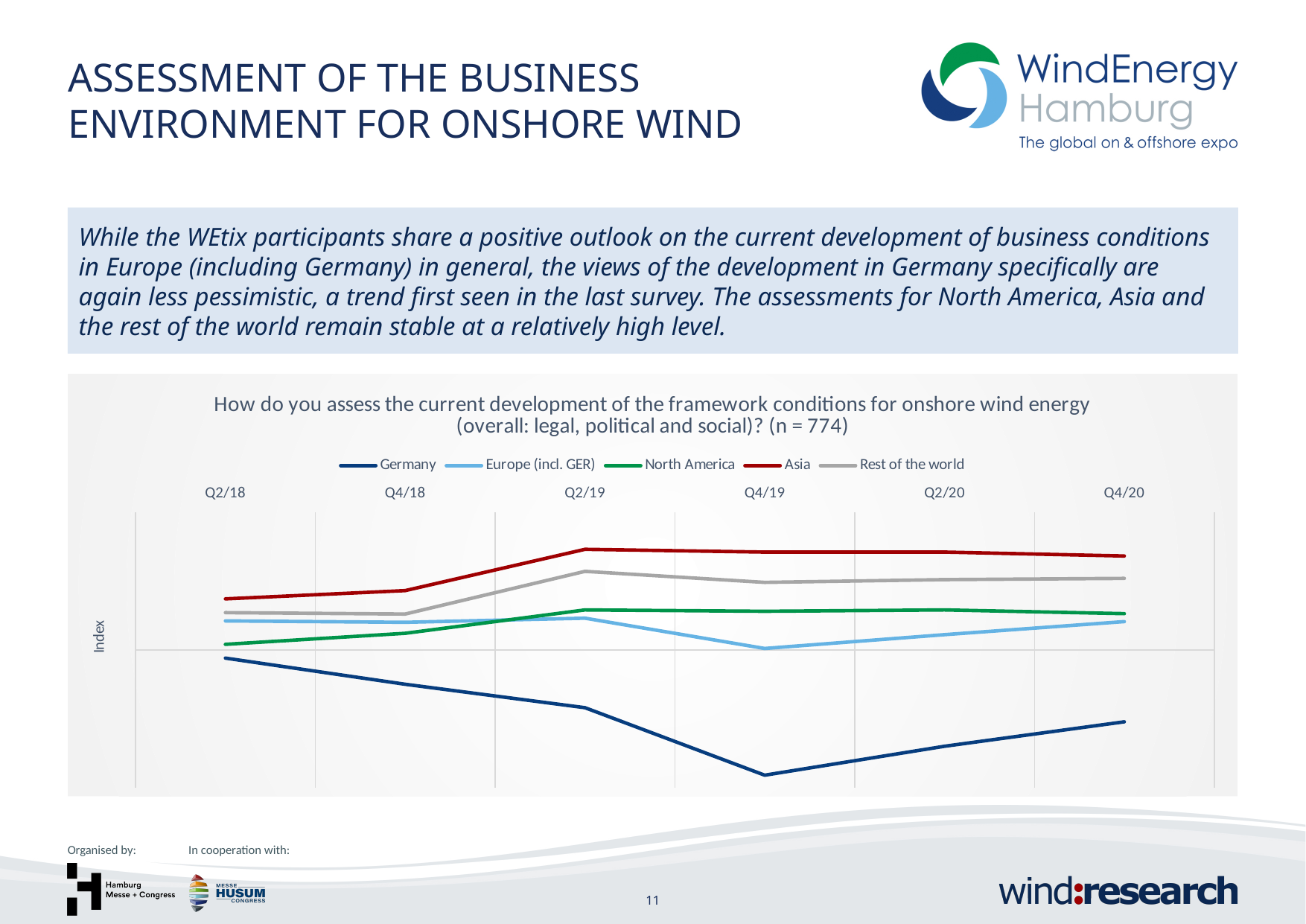
Which series has the lowest value at Q4/19? Germany How many series does the chart legend list? 5 At Q4/19, which is higher: North America or Europe (incl. GER)? North America What kind of chart is shown on the slide? Line chart What is the label on the vertical axis of the chart? Index How many time points are shown on the x axis of the chart? 6 Does the Germany series rise or fall from Q2/18 to Q4/19? Fall Which series has the highest value at Q4/20? Asia Which series has the lowest value across the whole chart? Germany Does the Germany series rise or fall from Q4/19 to Q4/20? Rise At Q2/19, which is higher: Asia or Rest of the world? Asia Does the Asia series rise or fall from Q2/18 to Q2/19? Rise